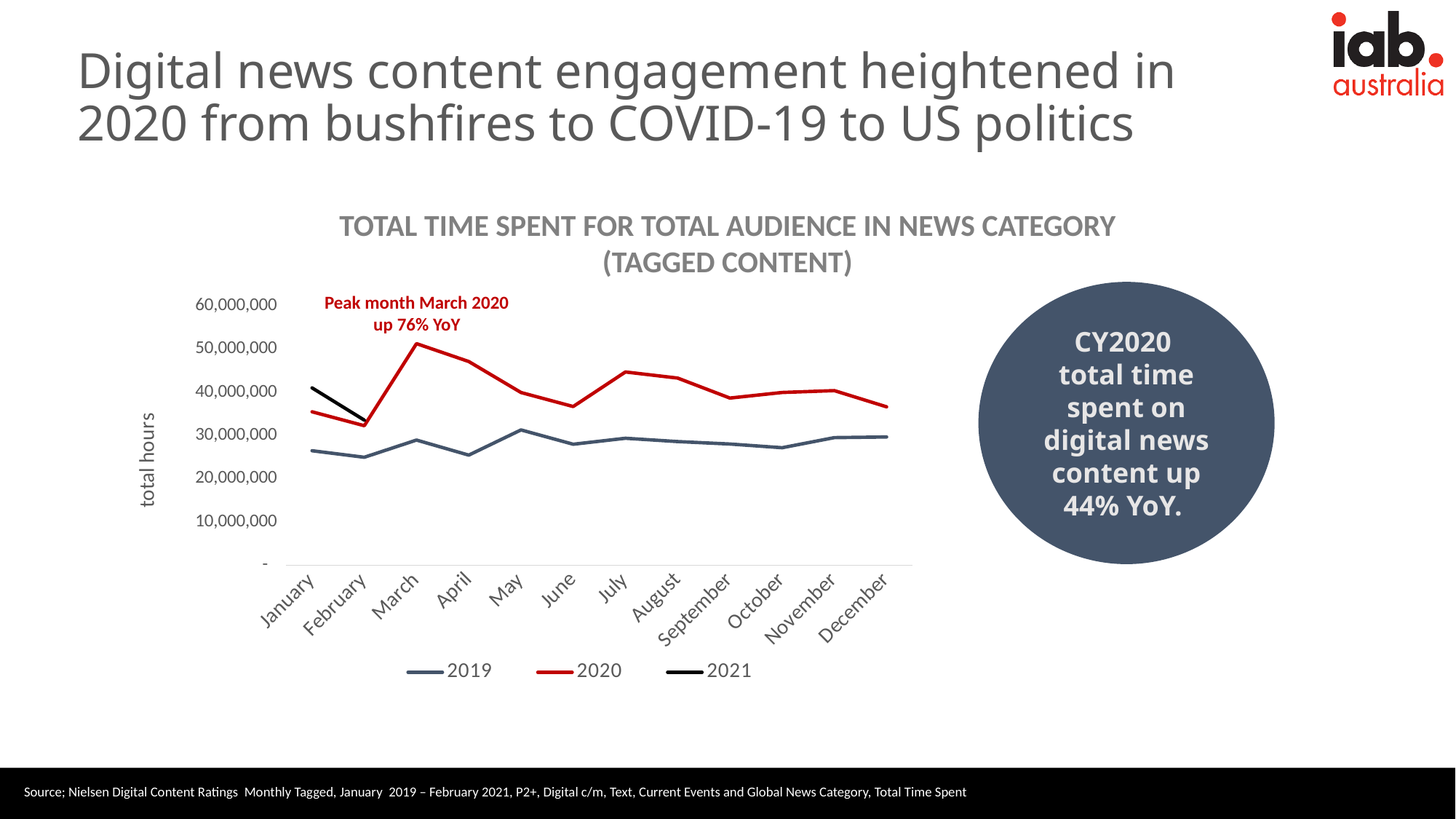
In which month does the 2020 series reach its highest value? March How many series does the legend list? 3 What kind of chart is shown on the slide? line chart According to the annotation on the chart, by what percentage was the peak month March 2020 up year on year? 76% How many months are plotted along the x axis? 12 Which is larger in March: the 2019 value or the 2020 value? 2020 In which month does the 2020 series reach its lowest value? February Is the value for 2020 in June greater or less than 40,000,000? less Which is larger in January: the 2020 value or the 2021 value? 2021 Is the value for 2020 in March greater or less than 40,000,000? greater Does the 2020 series rise or fall from March to June? fall Is the value for 2019 in January greater or less than 30,000,000? less